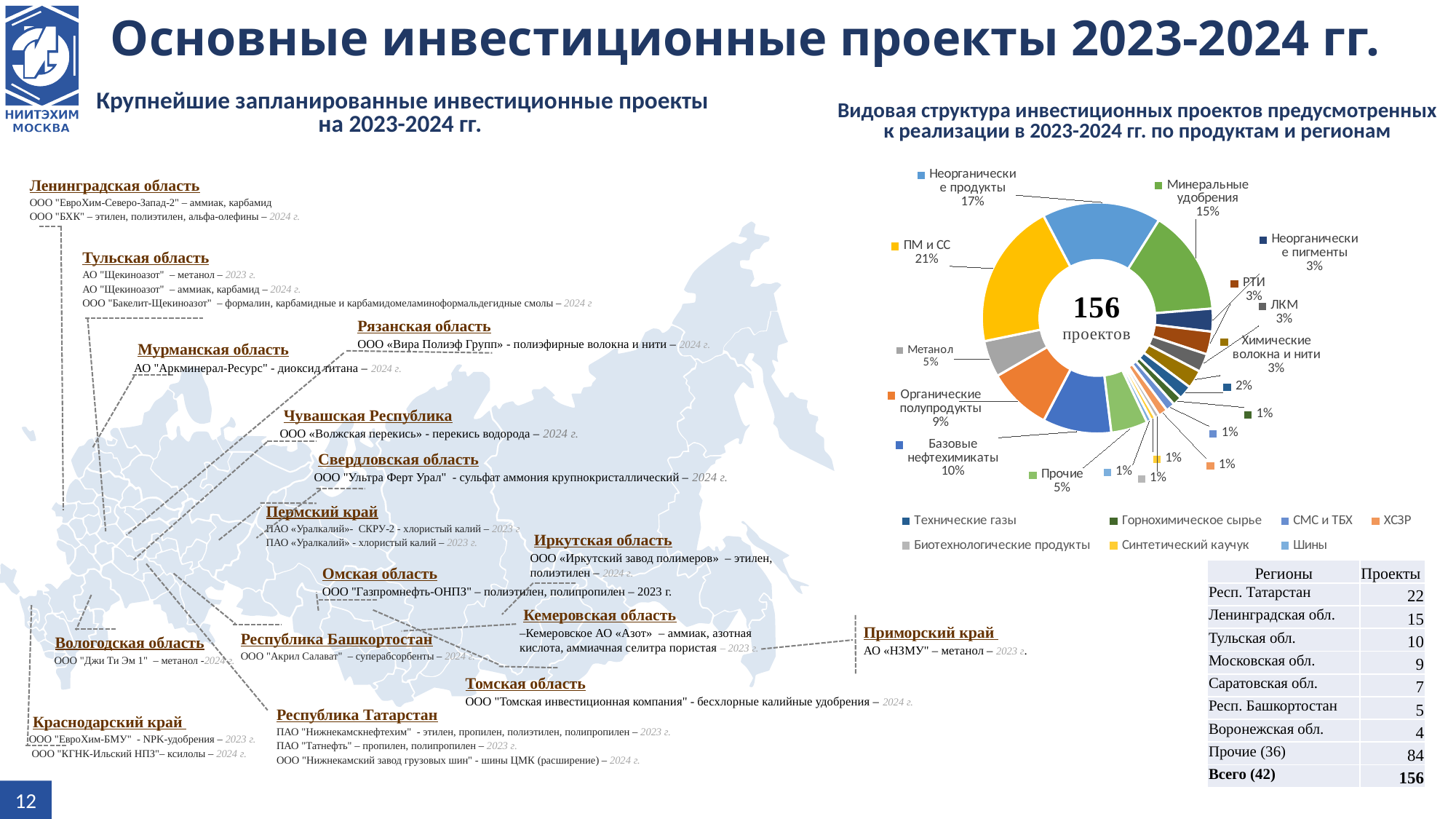
What share of the investment projects is attributed to Метанол? 5% What share of the investment projects is attributed to Неорганические продукты? 17% What share of the investment projects is attributed to Органические полупродукты? 9% What share of the investment projects is attributed to Базовые нефтехимикаты? 10% What share of the investment projects is attributed to Минеральные удобрения? 15% What is the difference in percentage points between the shares of ПМ и СС and Базовые нефтехимикаты? 11 percentage points What is the difference in percentage points between the shares of Неорганические продукты and Минеральные удобрения? 2 percentage points Which product category has the largest share in the pie chart? ПМ и СС What kind of chart is used to show the structure of investment projects by product? doughnut chart Which has a larger share: Метанол or Органические полупродукты? Органические полупродукты What total number of projects is shown in the centre of the pie chart? 156 проектов What share of the investment projects is attributed to ПМ и СС? 21%